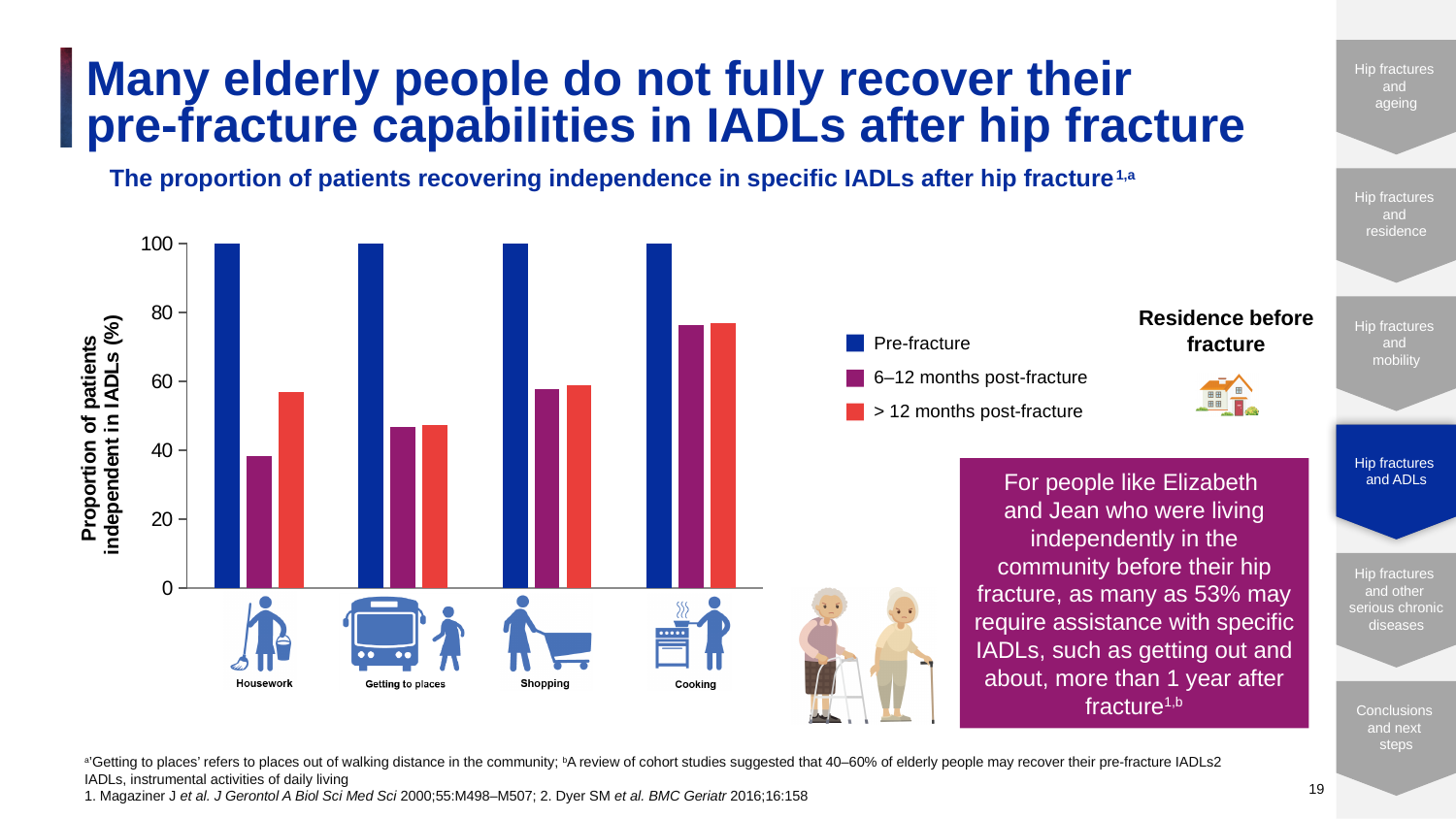
How many series does the chart legend list? 3 How many IADL categories are shown on the x axis of the chart? 4 Among the 6–12 months post-fracture bars, which IADL category has the highest value? Cooking Is the 6–12 months post-fracture value for Housework greater or less than 40? less What is the pre-fracture value for Housework? 100 What kind of chart is shown on the slide? Bar chart Among the 6–12 months post-fracture bars, which IADL category has the lowest value? Housework Is the 6–12 months post-fracture value for Getting to places greater or less than 60? less Is the > 12 months post-fracture value for Cooking greater or less than 60? greater What is the pre-fracture value for Cooking? 100 Which is larger for Housework: the 6–12 months post-fracture value or the > 12 months post-fracture value? > 12 months post-fracture